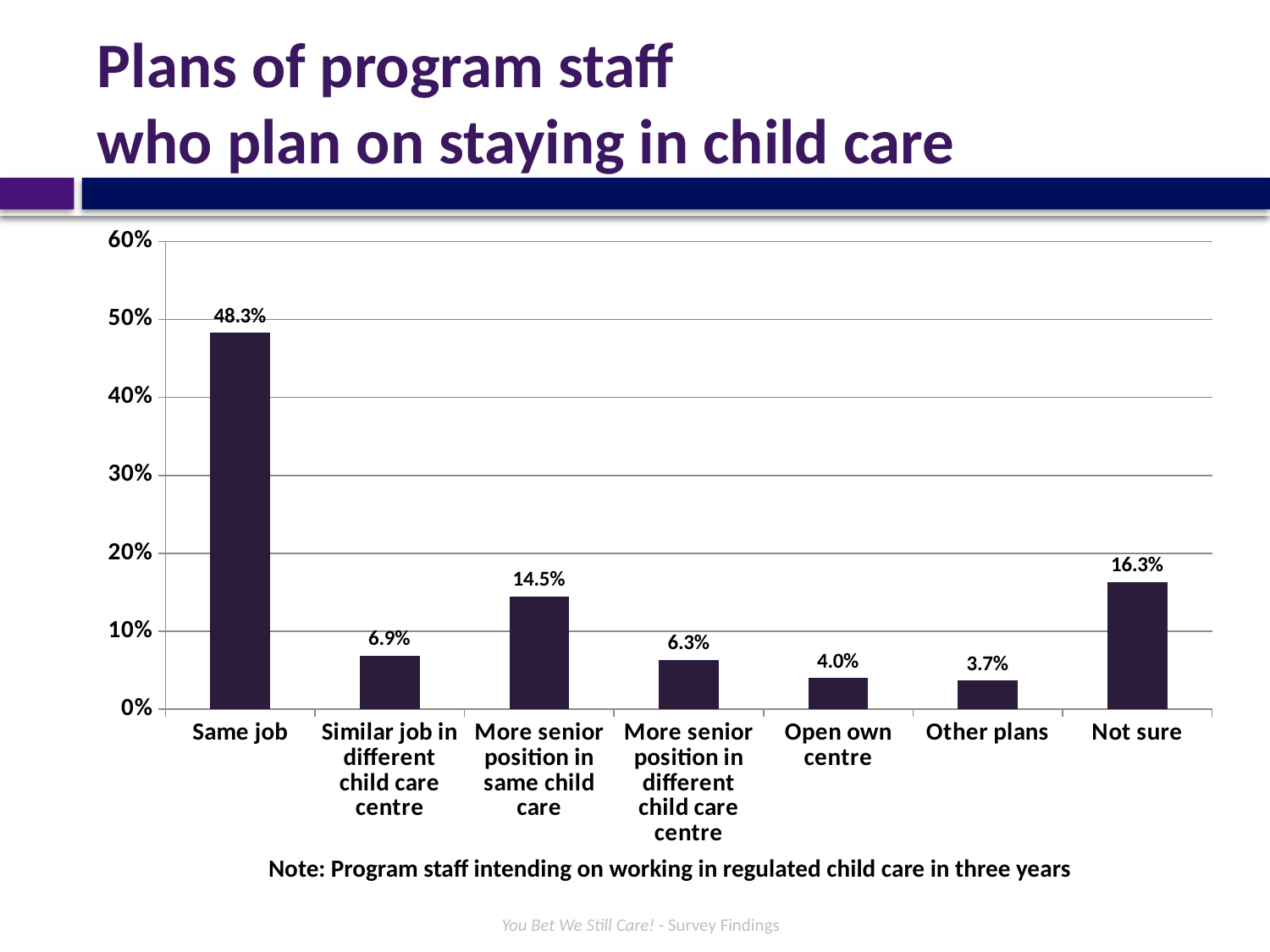
How many categories are shown on the x axis? 7 What is the value for 'Not sure'? 16.3% What is the title of the slide? Plans of program staff who plan on staying in child care What is the difference between 'Same job' and 'Not sure'? 32.0% What percentage plan to take a more senior position in the same child care? 14.5% Which is larger: 'More senior position in same child care' or 'Not sure'? Not sure What percentage of program staff plan to stay in the same job? 48.3% What is the value for 'Open own centre'? 4.0% Which category has the highest value? Same job Which category has the lowest value? Other plans What is the difference between 'Similar job in different child care centre' and 'More senior position in different child care centre'? 0.6% What kind of chart is shown on the slide? Bar chart